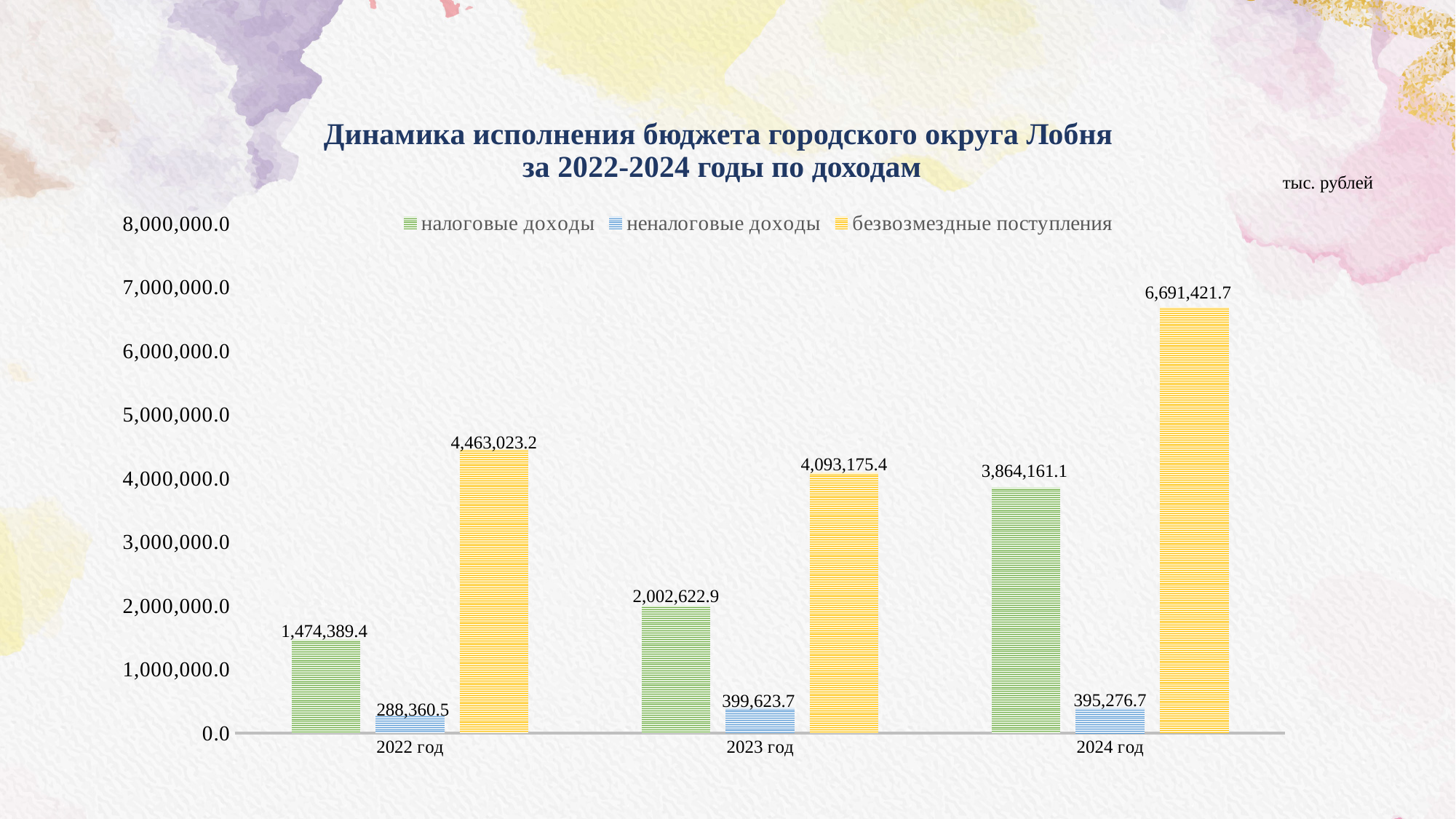
How many years are shown on the x axis? 3 What is the value of неналоговые доходы for 2023 год? 399,623.7 Which year has the lowest value for неналоговые доходы? 2022 год Do the values for налоговые доходы rise or fall from 2022 год to 2024 год? rise Which is larger: налоговые доходы in 2024 год or безвозмездные поступления in 2023 год? безвозмездные поступления in 2023 год Is the value of налоговые доходы for 2023 год greater or less than 2,000,000.0? greater Which year has the highest value for безвозмездные поступления? 2024 год What is the difference between безвозмездные поступления in 2024 год and in 2022 год? 2,228,398.5 What is the value of налоговые доходы for 2022 год? 1,474,389.4 How many series does the legend list? 3 What is the difference between налоговые доходы in 2024 год and in 2023 год? 1,861,538.2 What is the value of безвозмездные поступления for 2024 год? 6,691,421.7